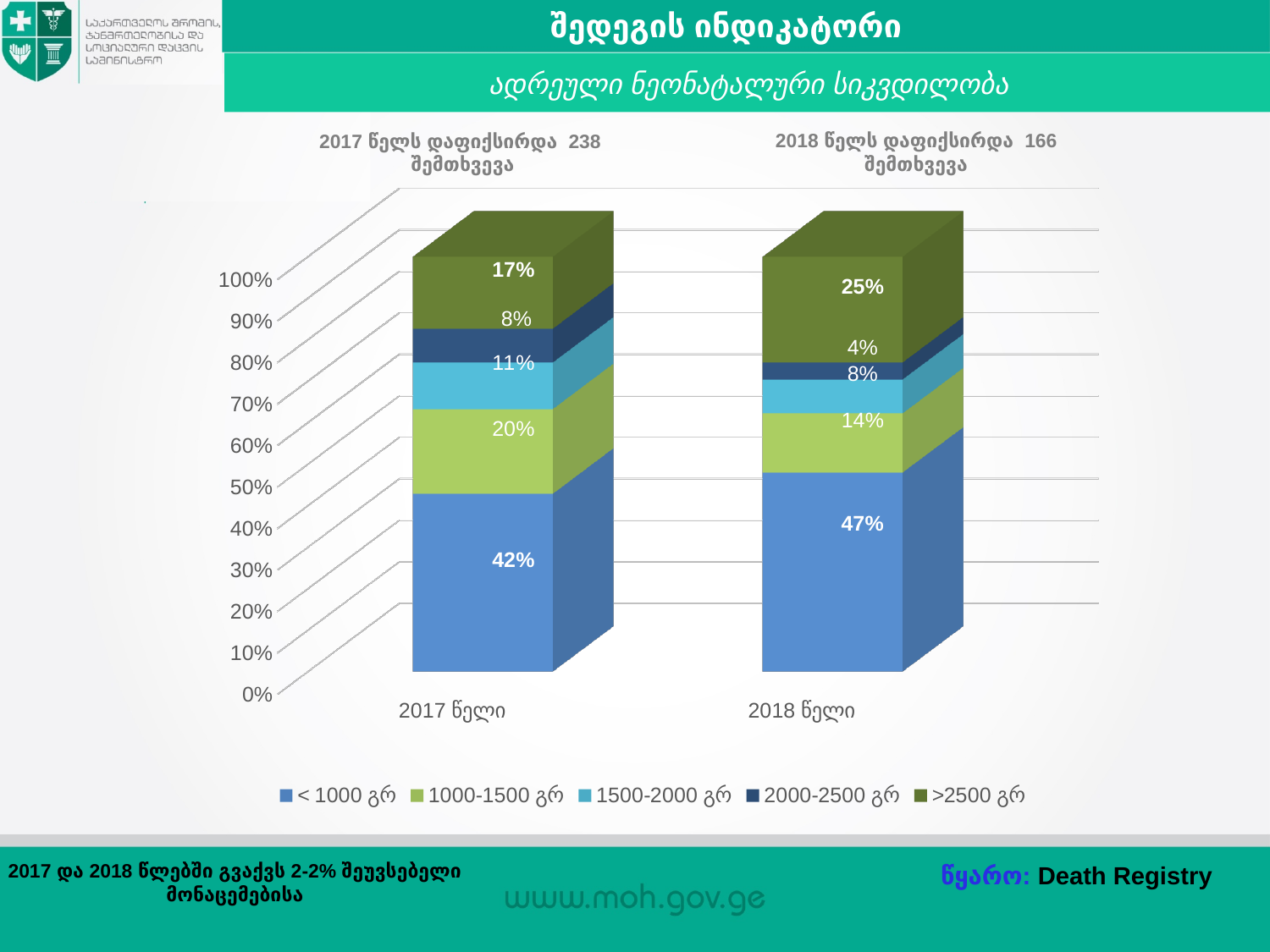
What is the value for 1000-1500 გრ in 2018 წელი? 14% How many categories (bars) are shown on the x axis? 2 What is the value for >2500 გრ in 2018 წელი? 25% How many series does the legend list? 5 What kind of chart is shown on the slide? stacked bar chart What is the value for < 1000 გრ in 2017 წელი? 42% What is the value for 2000-2500 გრ in 2017 წელი? 8% Which weight group has the smallest share in the 2018 წელი bar? 2000-2500 გრ Which is larger: the 1500-2000 გრ value in 2017 წელი or in 2018 წელი? 2017 წელი What is the total of the labelled segments in the 2017 წელი bar? 98% Which weight group has the largest share in the 2018 წელი bar? < 1000 გრ What is the difference between the < 1000 გრ values for 2018 წელი and 2017 წელი? 5%